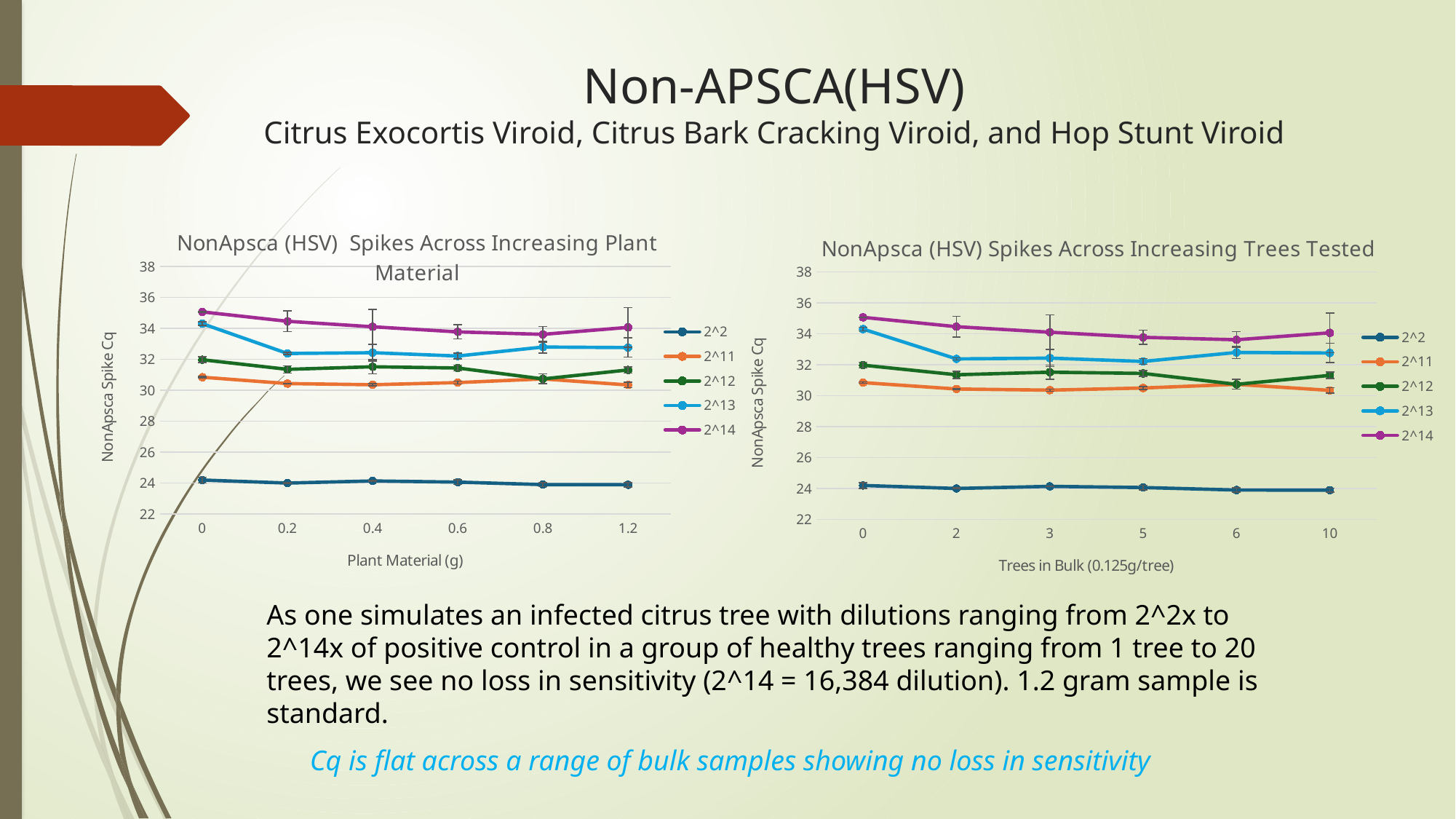
In the left chart, 'NonApsca (HSV) Spikes Across Increasing Plant Material', is the value for series 2^2 at 0 g greater or less than 26? less In the right chart, 'NonApsca (HSV) Spikes Across Increasing Trees Tested', which is larger at 5 trees: series 2^13 or series 2^2? 2^13 What is the x-axis label of the right chart, 'NonApsca (HSV) Spikes Across Increasing Trees Tested'? Trees in Bulk (0.125g/tree) In the right chart, 'NonApsca (HSV) Spikes Across Increasing Trees Tested', which series has the lowest value at 10 trees in bulk? 2^2 In the left chart, 'NonApsca (HSV) Spikes Across Increasing Plant Material', is the value for series 2^11 at 0.4 g greater or less than 32? less What kind of chart is the left chart, 'NonApsca (HSV) Spikes Across Increasing Plant Material'? line chart In the left chart, 'NonApsca (HSV) Spikes Across Increasing Plant Material', which series has the highest value at plant material 0 g? 2^14 How many x-axis categories are plotted in the left chart, 'NonApsca (HSV) Spikes Across Increasing Plant Material'? 6 How many series does the legend of the right chart, 'NonApsca (HSV) Spikes Across Increasing Trees Tested', list? 5 What is the y-axis label of the left chart, 'NonApsca (HSV) Spikes Across Increasing Plant Material'? NonApsca Spike Cq In the left chart, 'NonApsca (HSV) Spikes Across Increasing Plant Material', which is larger at 0.8 g: series 2^14 or series 2^12? 2^14 In the right chart, 'NonApsca (HSV) Spikes Across Increasing Trees Tested', is the value for series 2^14 at 0 trees greater or less than 34? greater